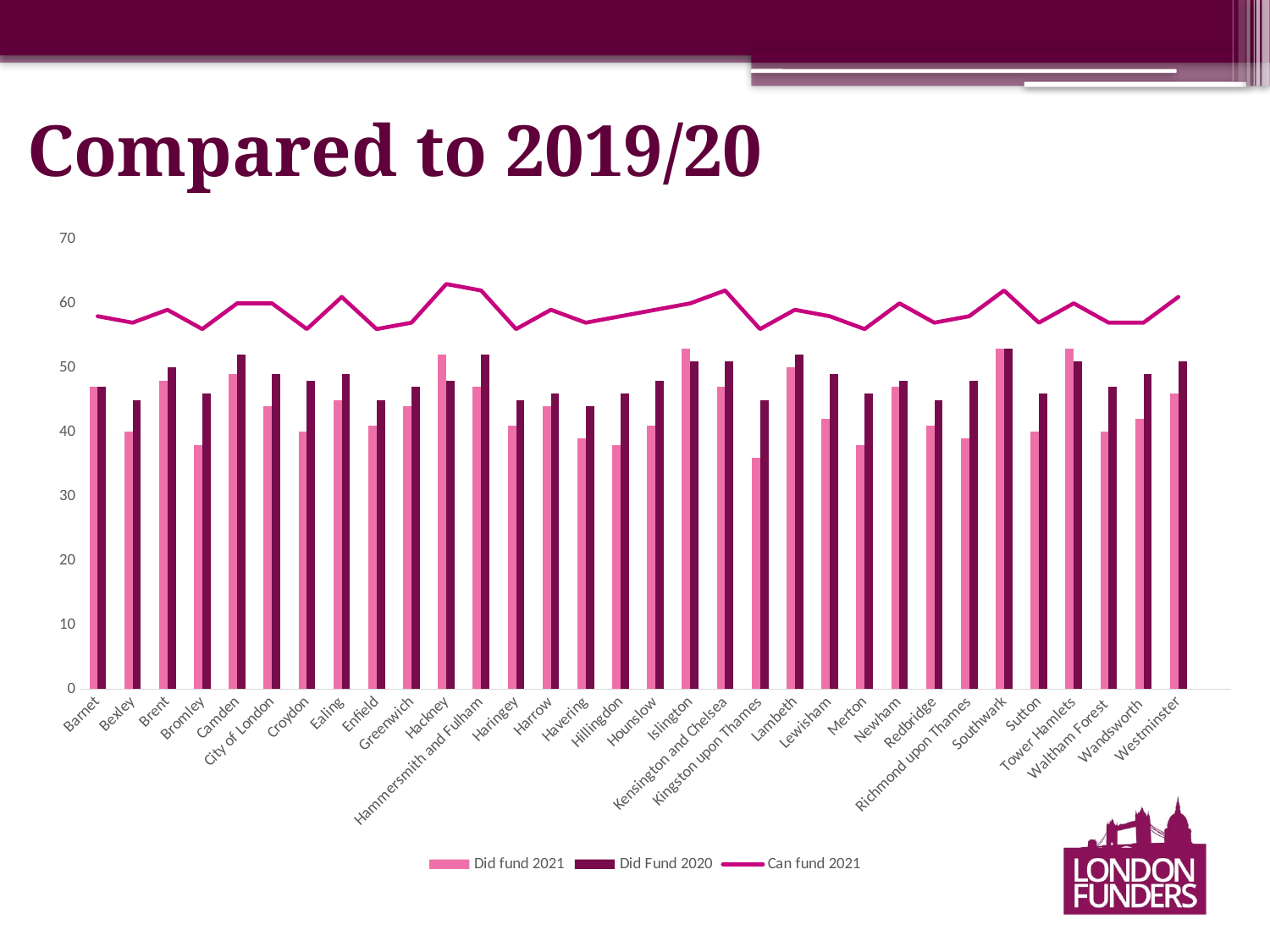
Is the Did fund 2021 value for Kingston upon Thames greater or less than 40? less What is the title of the slide containing the chart? Compared to 2019/20 For Hackney, which is larger: Did fund 2021 or Did Fund 2020? Did fund 2021 Which borough has the lowest Did fund 2021 value? Kingston upon Thames Is the Can fund 2021 value for Hackney greater or less than 60? greater Is the Did fund 2021 value for Bromley greater or less than 40? less How many boroughs (categories) are shown on the x axis? 32 Which series is drawn as a line rather than bars? Can fund 2021 For Kingston upon Thames, which is larger: Did fund 2021 or Did Fund 2020? Did Fund 2020 How many series does the legend list? 3